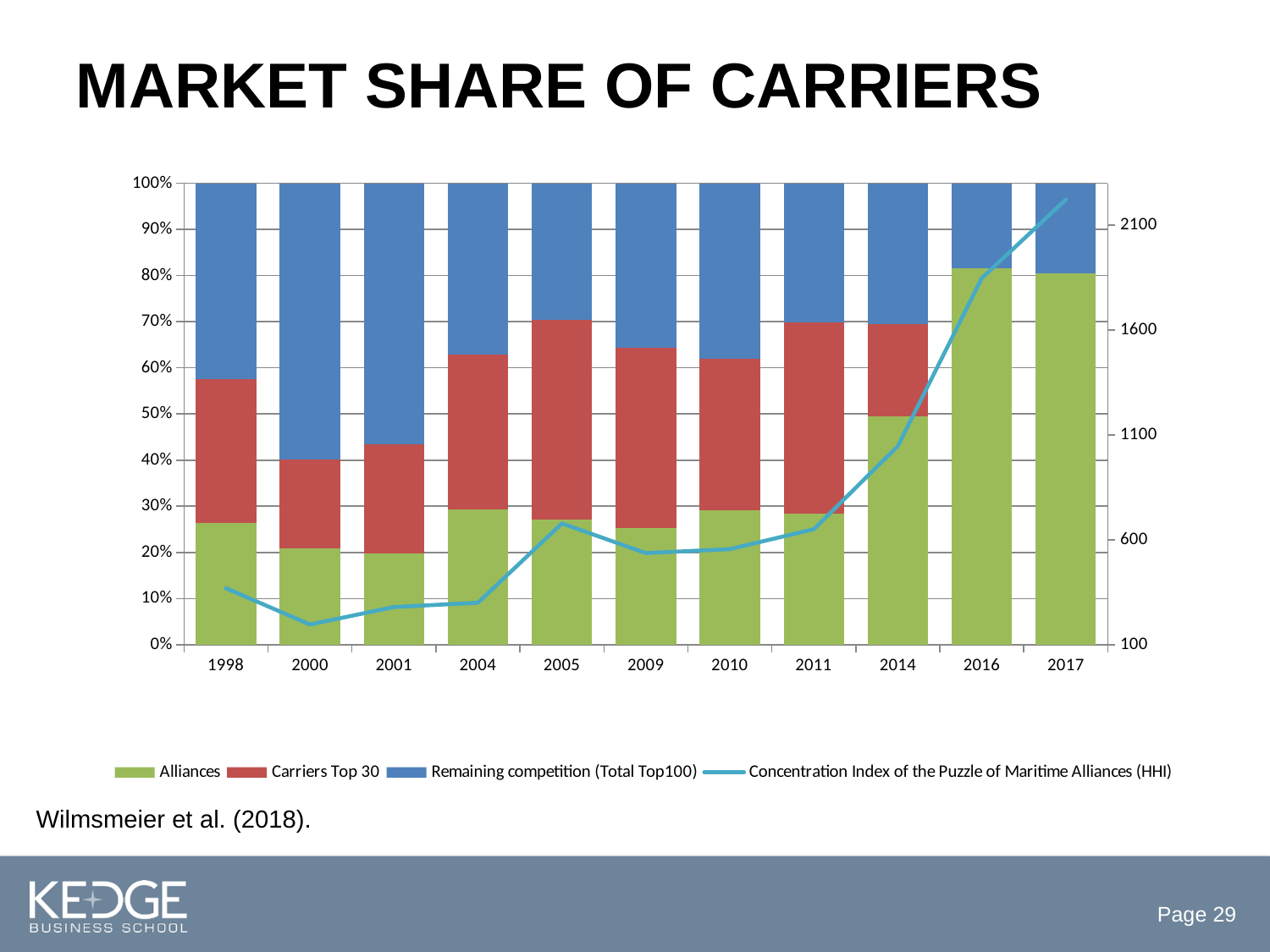
How many years are shown along the x axis of the chart? 11 Does the Concentration Index (HHI) line rise or fall from 2011 to 2017? rise What is the total of the stacked bar for 1998? 100% What kind of chart is shown on the slide? Stacked bar chart with a line Is the Concentration Index (HHI) value in 2016 greater or less than 1600? greater What is the title of the slide containing the chart? MARKET SHARE OF CARRIERS Is the Alliances share in 1998 greater or less than 30%? less In which year is the Concentration Index (HHI) line at its highest? 2017 Is the Alliances share in 2014 greater or less than 40%? greater Which year has the larger Alliances share, 2009 or 2014? 2014 In which year is the Concentration Index (HHI) line at its lowest? 2000 How many series does the chart legend list? 4